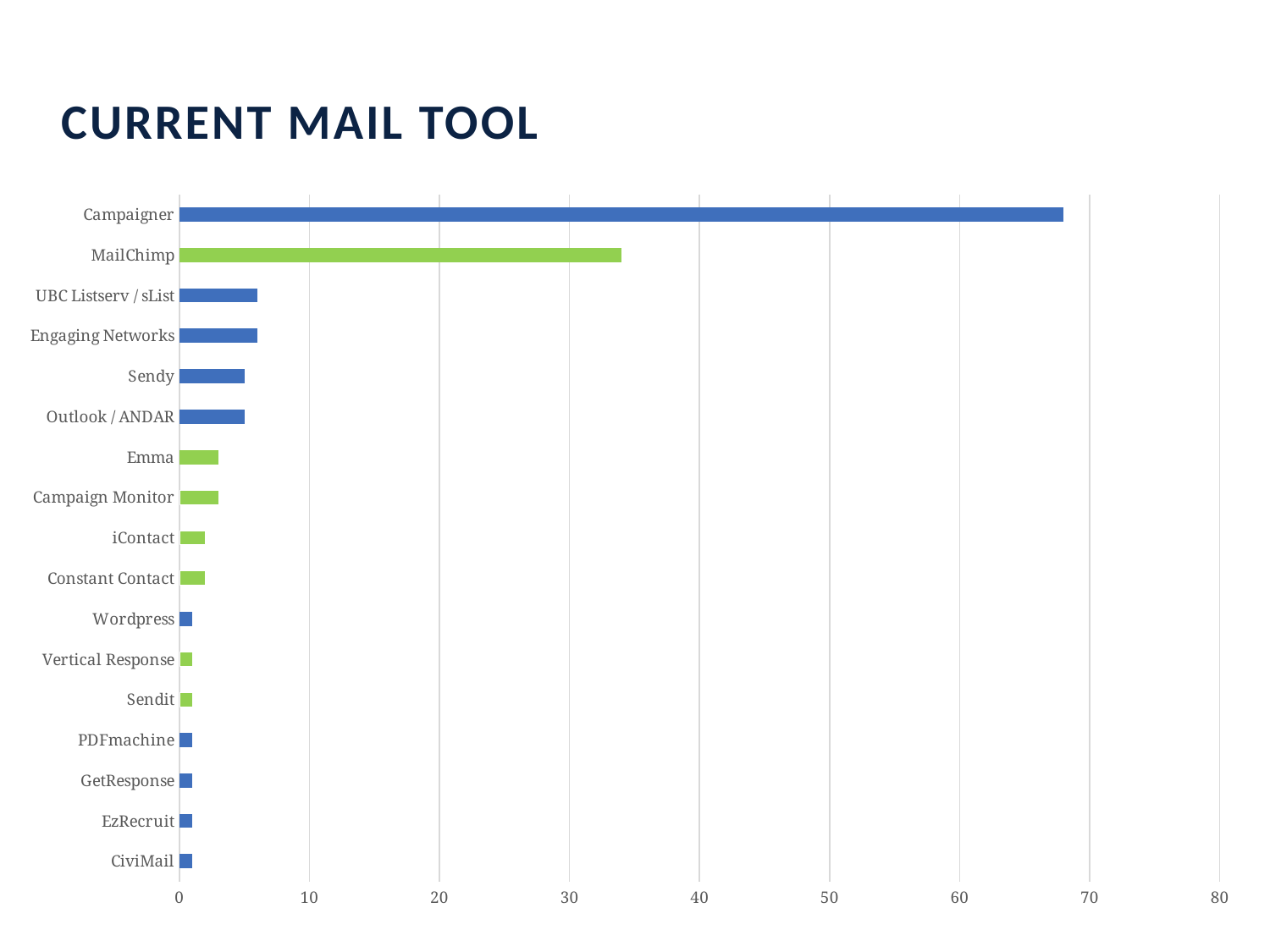
Is the value for MailChimp greater or less than 40? less How many mail tools (categories) are listed on the chart? 17 Which mail tool has the highest value? Campaigner Which has a larger value, Engaging Networks or Emma? Engaging Networks Is the value for UBC Listserv / sList greater or less than 10? less What kind of chart is shown on the slide? bar chart Which has a larger value, MailChimp or Sendy? MailChimp Which has a larger value, Campaigner or MailChimp? Campaigner What is the title of the chart? CURRENT MAIL TOOL Is the value for Campaigner greater or less than 60? greater